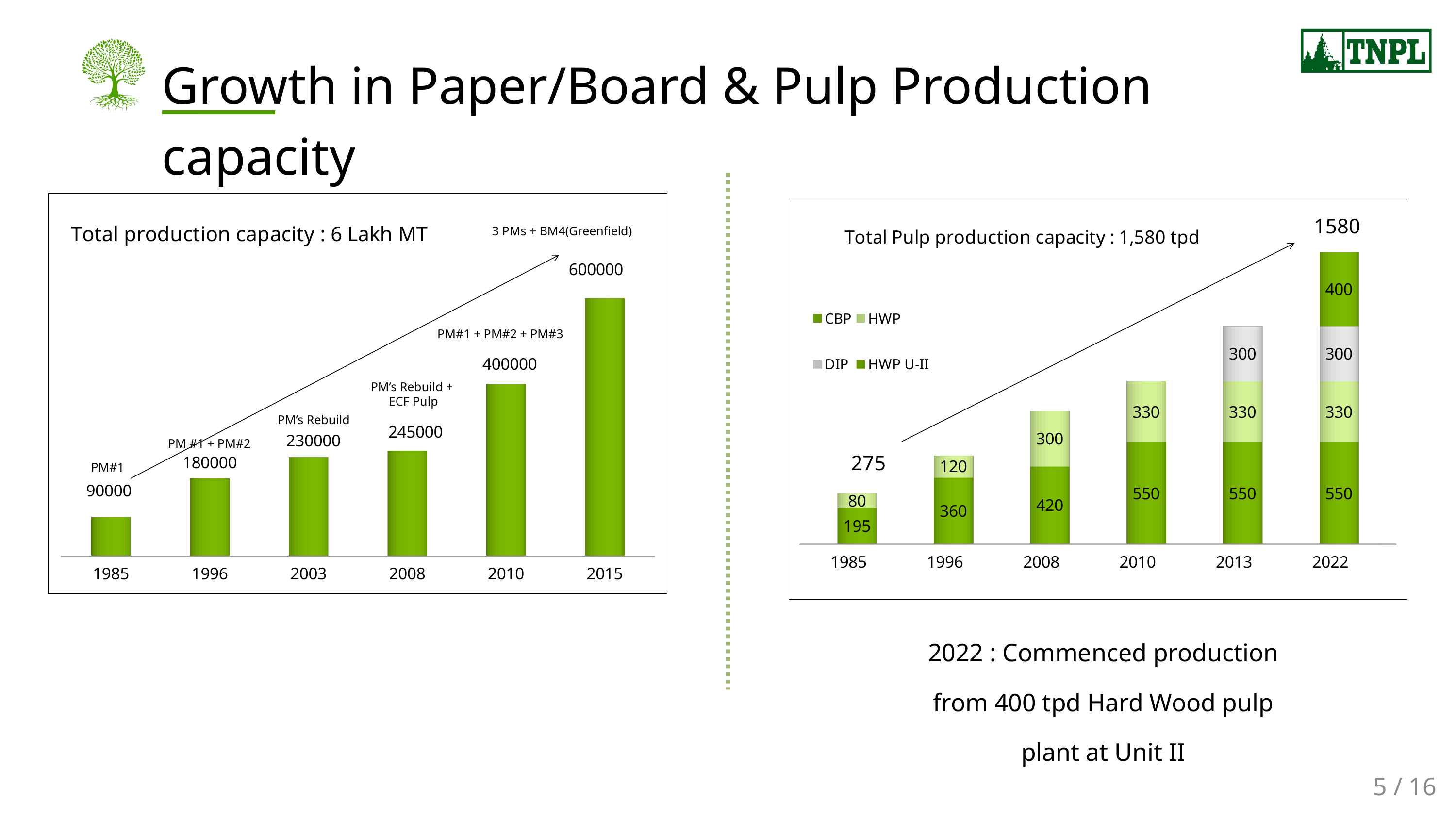
In the right chart (Total Pulp production capacity : 1,580 tpd), which is larger, the HWP value for 1996 or the HWP value for 2008? 2008 In the right chart (Total Pulp production capacity : 1,580 tpd), what is the HWP U-II value for 2022? 400 In the right chart (Total Pulp production capacity : 1,580 tpd), what is the CBP value for 2008? 420 In the right chart (Total Pulp production capacity : 1,580 tpd), what is the total of the stacked bar for 2013? 1180 In the right chart (Total Pulp production capacity : 1,580 tpd), what is the difference between the CBP values for 1996 and 1985? 165 In the left chart (Total production capacity : 6 Lakh MT), do the values rise or fall from 1985 to 2015? rise In the left chart (Total production capacity : 6 Lakh MT), what is the difference between the values for 2015 and 2010? 200000 In the left chart (Total production capacity : 6 Lakh MT), which year has the lowest value? 1985 What kind of chart is the left chart (Total production capacity : 6 Lakh MT)? bar chart In the left chart (Total production capacity : 6 Lakh MT), what is the value for 2003? 230000 In the left chart (Total production capacity : 6 Lakh MT), how many years are shown on the x axis? 6 In the right chart (Total Pulp production capacity : 1,580 tpd), how many series does the legend list? 4